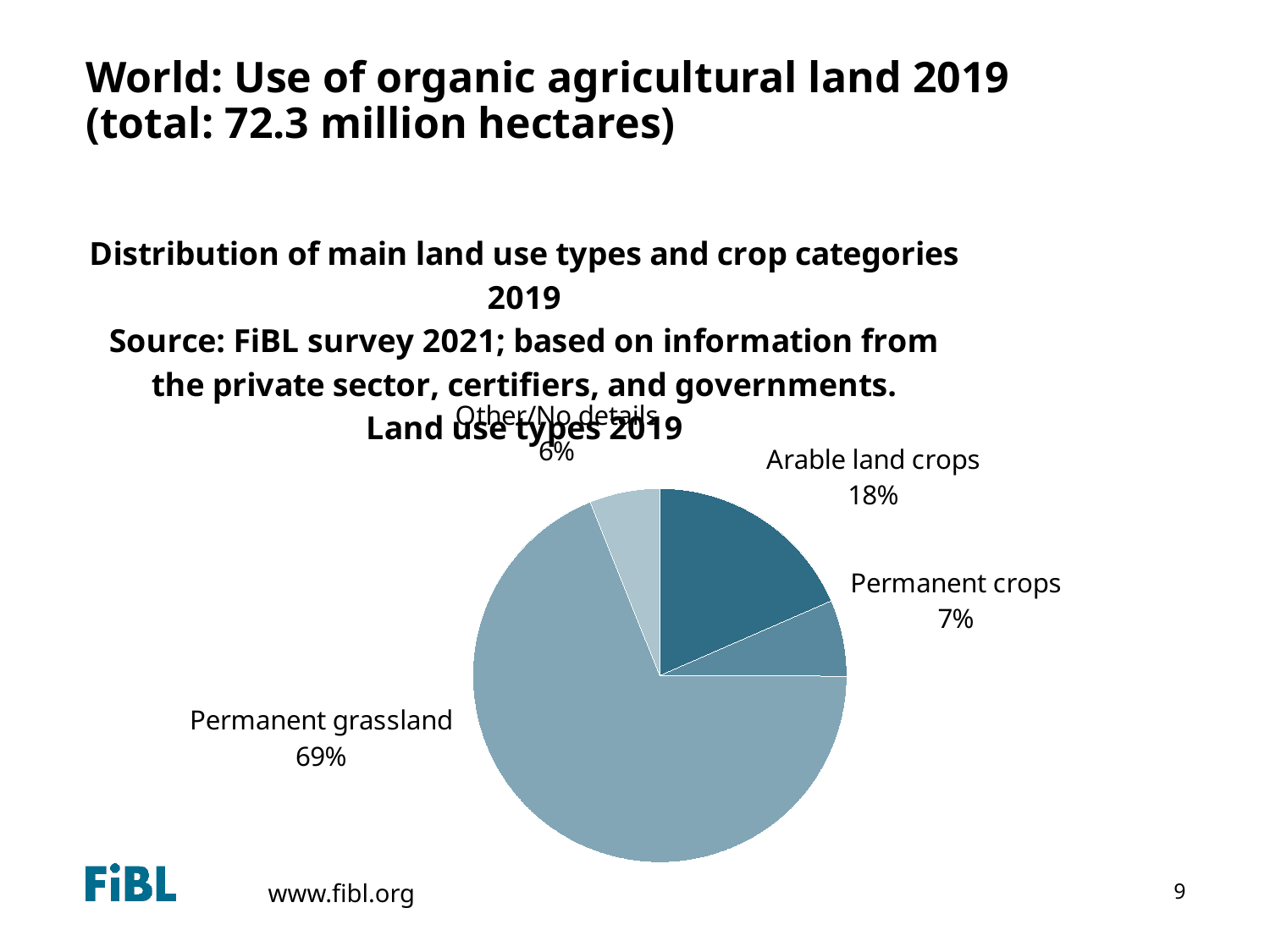
How many slices does the pie chart have? 4 What share of organic agricultural land is permanent grassland? 69% What type of chart is shown on the slide? pie chart What share of organic agricultural land is arable land crops? 18% What is the difference in percentage points between permanent grassland and arable land crops? 51 What is the total organic agricultural land area stated in the slide title? 72.3 million hectares Which land use type has the largest share of the pie? Permanent grassland Which land use type has the smallest share of the pie? Other/No details What is the title of the pie chart? Land use types 2019 Which is larger, the share for arable land crops or the share for permanent crops? Arable land crops What share of organic agricultural land is permanent crops? 7% What share of organic agricultural land is Other/No details? 6%